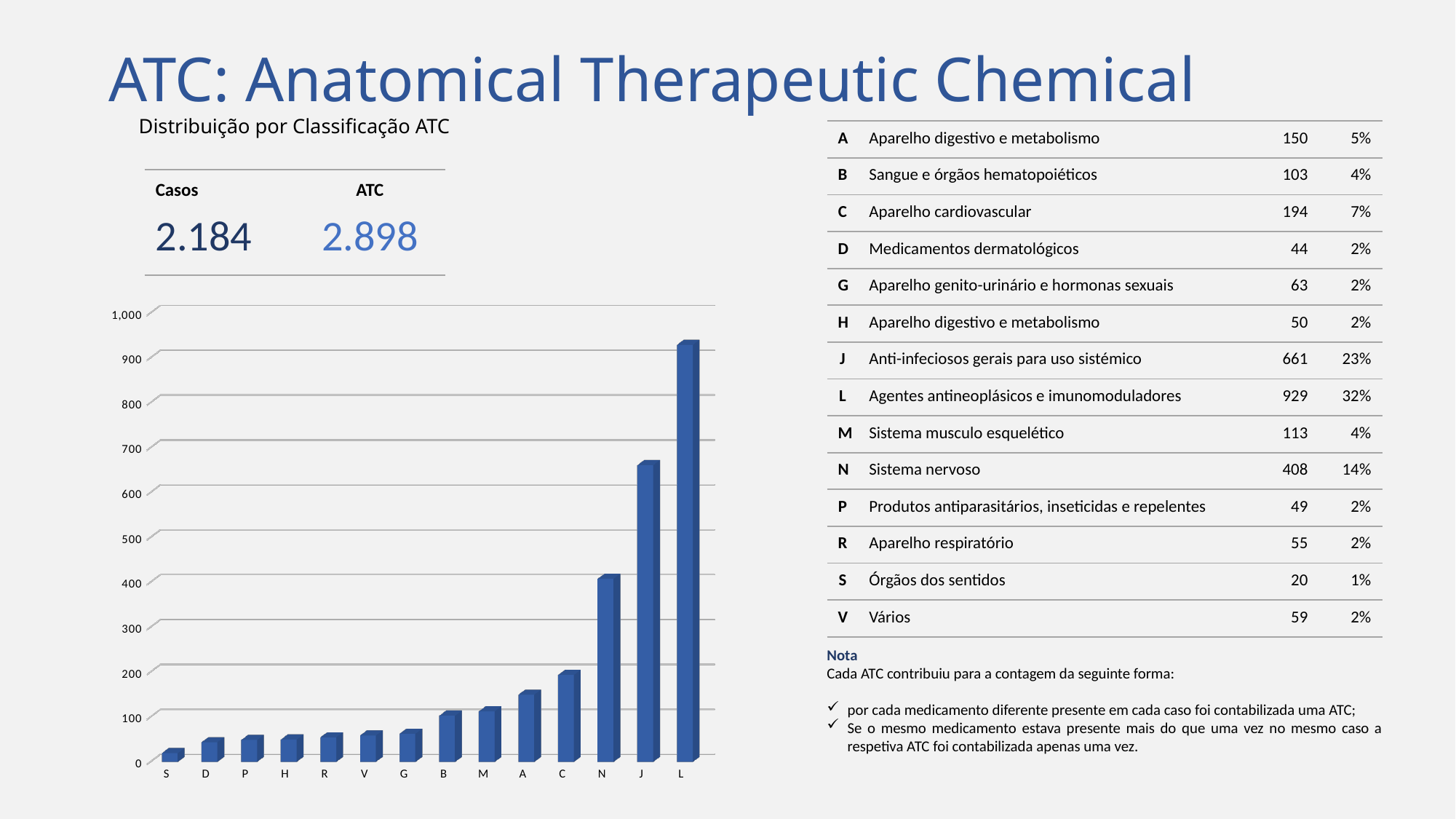
Is the value for L greater or less than 900? greater Is the value for S greater or less than 100? less Is the value for N greater or less than 500? less Do the bar values rise or fall from left to right along the x axis? rise Which category has the tallest bar in the chart? L According to the table on the slide, what is the count for category L (Agentes antineoplásicos e imunomoduladores)? 929 Which bar is taller, C or A? C What is the title shown above the chart? Distribuição por Classificação ATC Which category has the shortest bar in the chart? S How many categories are plotted along the x axis of the chart? 14 What kind of chart is shown on the slide? bar chart